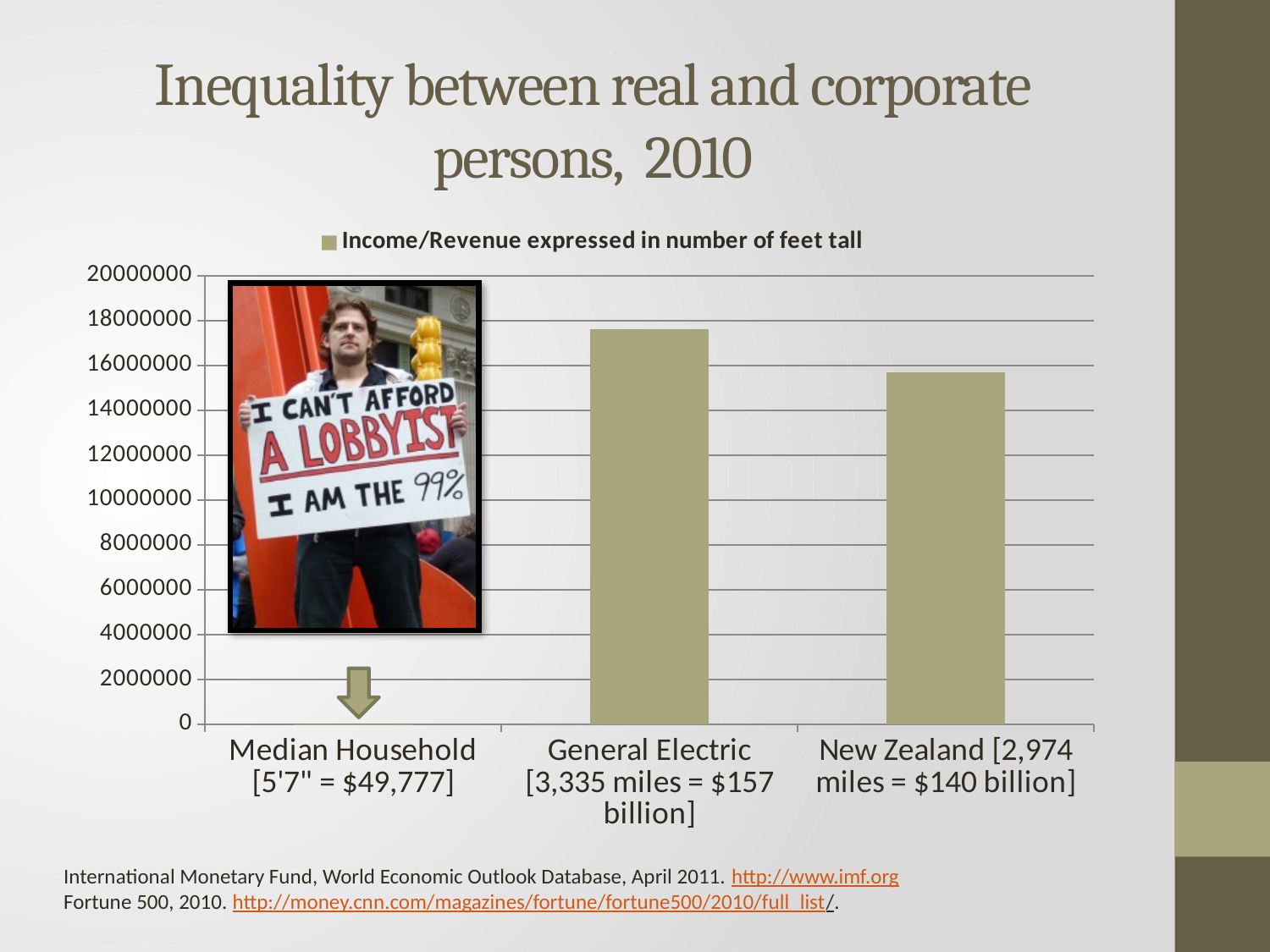
Is the value for New Zealand greater or less than 14000000? greater How many categories are plotted on the chart? 3 What is the series name shown in the chart legend? Income/Revenue expressed in number of feet tall What is the title of the slide containing the chart? Inequality between real and corporate persons, 2010 Which is larger, the value for General Electric or the value for New Zealand? General Electric Which category has the lowest value? Median Household [5'7" = $49,777] How many series does the chart legend list? 1 Is the value for Median Household greater or less than 2000000? less What kind of chart is shown on the slide? Bar chart Is the value for New Zealand greater or less than 18000000? less Which category has the tallest bar? General Electric [3,335 miles = $157 billion]